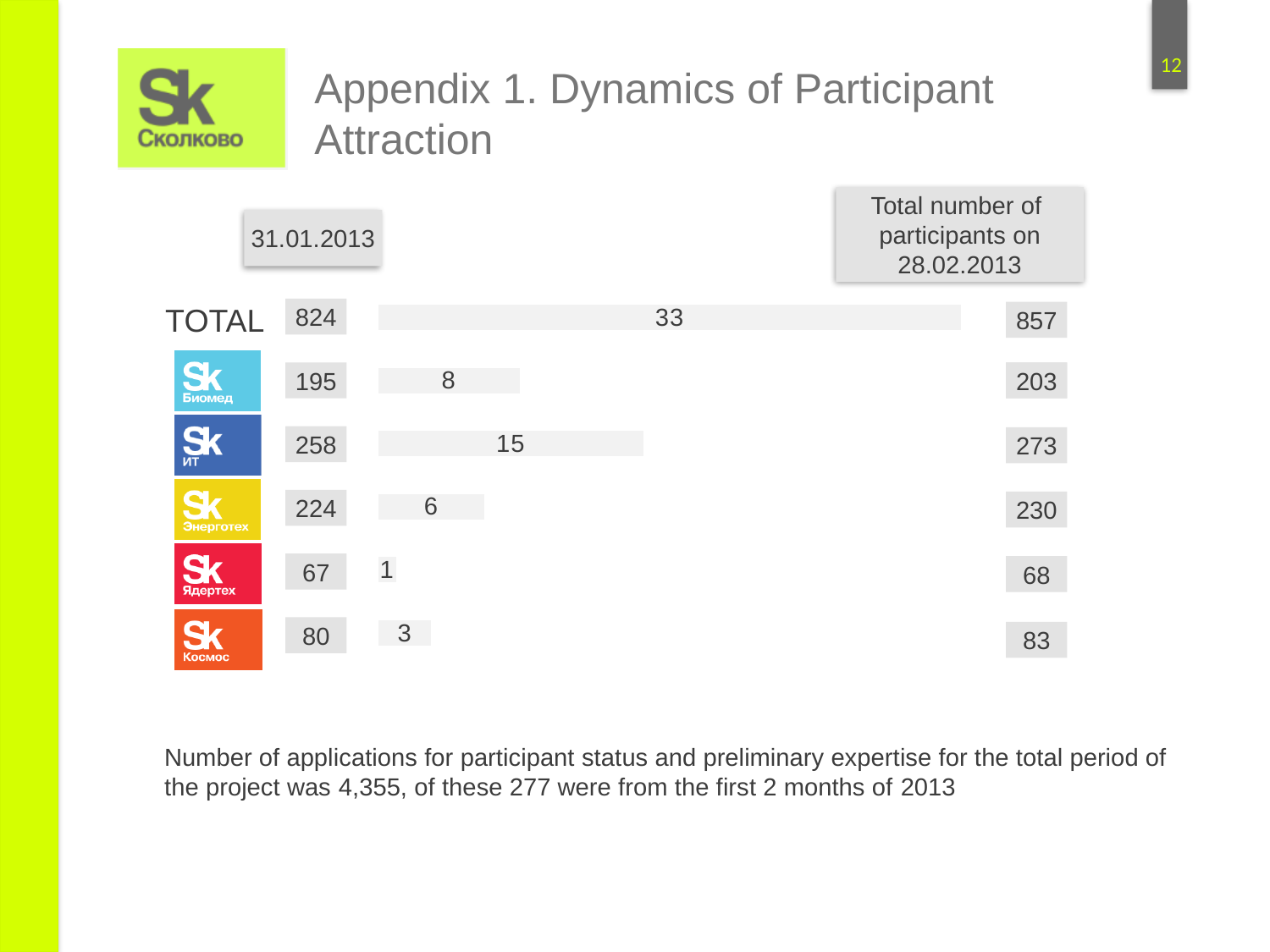
What is the value of the bar for Биомед? 8 What is the number of participants on 31.01.2013 for Энерготех? 224 What is the total number of participants on 28.02.2013 for ИТ? 273 What is the difference between the bar values for ИТ and Энерготех? 9 What is the value of the bar for ИТ? 15 What is the value of the bar for Космос? 3 How many cluster rows are shown below the TOTAL row? 5 Which has a larger bar value, Биомед or Энерготех? Биомед What is the value of the TOTAL bar? 33 Excluding the TOTAL row, which cluster has the longest bar? ИТ Excluding the TOTAL row, which cluster has the shortest bar? Ядертех What kind of chart is shown on the slide? bar chart